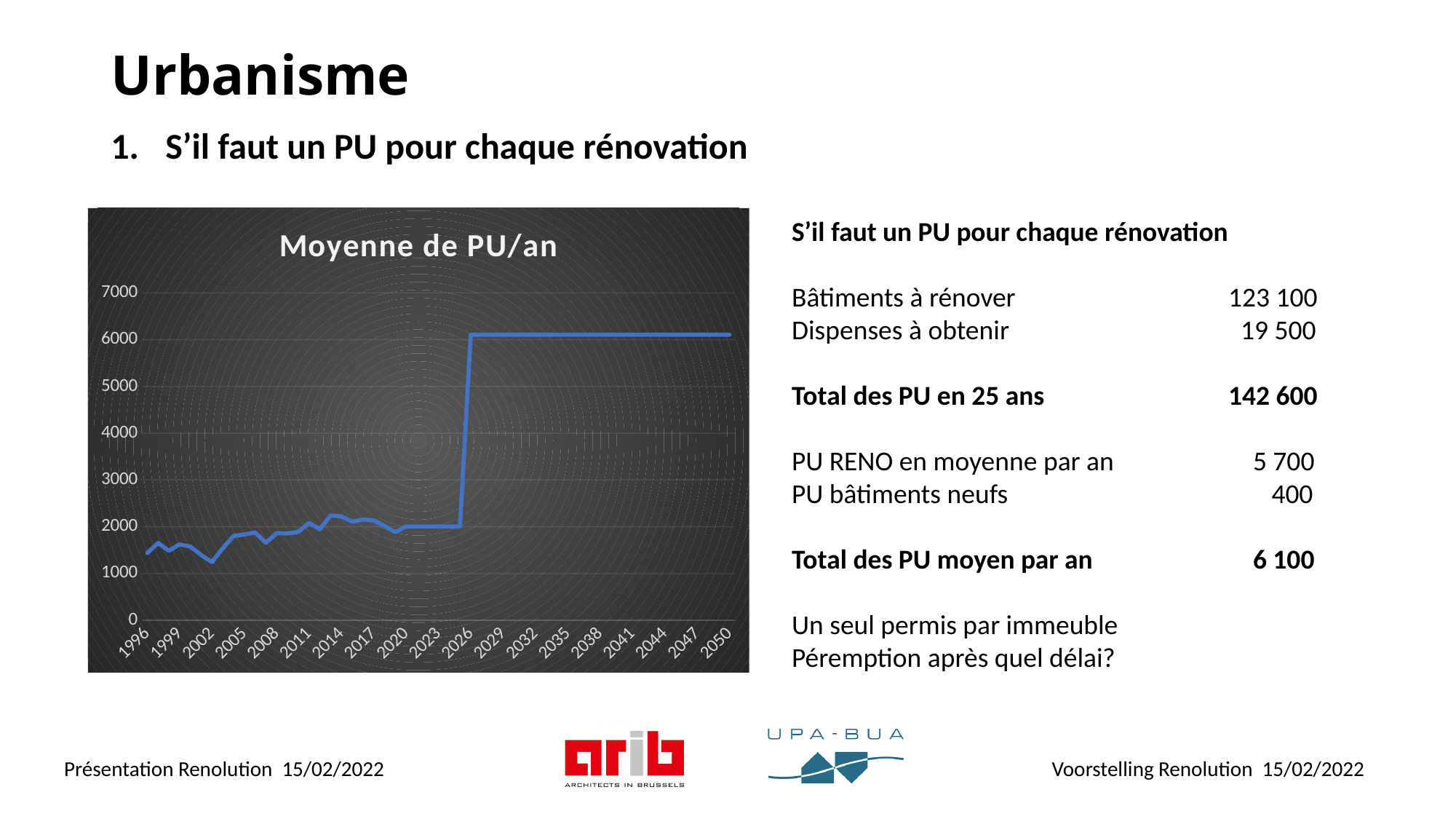
Which year has the larger value, 1996 or 2050? 2050 What is the title of the chart? Moyenne de PU/an Is the value for 2038 greater or less than 4000? greater Around which year does the line jump sharply upward? 2026 How many year labels are shown on the x axis? 19 Is the value for 1996 greater or less than 2000? less Does the line generally rise or fall between 1996 and 2023? rise Which year has the larger value, 2014 or 2029? 2029 Is the value for 2020 greater or less than 3000? less What kind of chart is shown on the slide? line chart